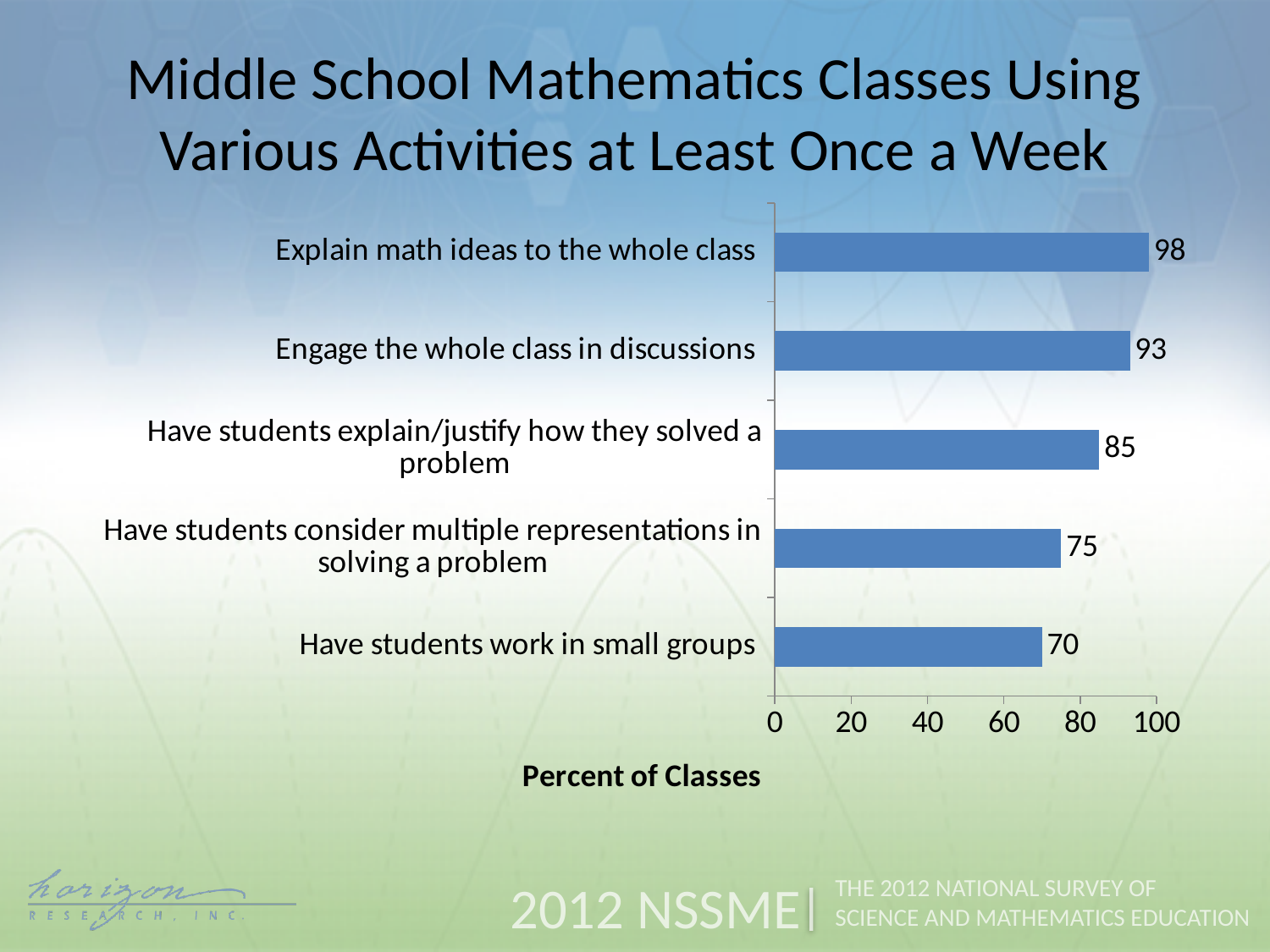
What kind of chart is shown on the slide? bar chart What is the value for "Have students explain/justify how they solved a problem"? 85 Which is larger: the value for "Engage the whole class in discussions" or "Have students consider multiple representations in solving a problem"? Engage the whole class in discussions What is the difference between the values for "Have students explain/justify how they solved a problem" and "Have students consider multiple representations in solving a problem"? 10 How many activities are shown in the chart? 5 What is the value for "Engage the whole class in discussions"? 93 Which activity has the lowest percent of classes? Have students work in small groups What is the difference between the values for "Explain math ideas to the whole class" and "Have students work in small groups"? 28 What percent of classes have students work in small groups at least once a week? 70 What is the label of the horizontal axis? Percent of Classes Which activity has the highest percent of classes? Explain math ideas to the whole class Is the value for "Have students consider multiple representations in solving a problem" greater or less than 80? less